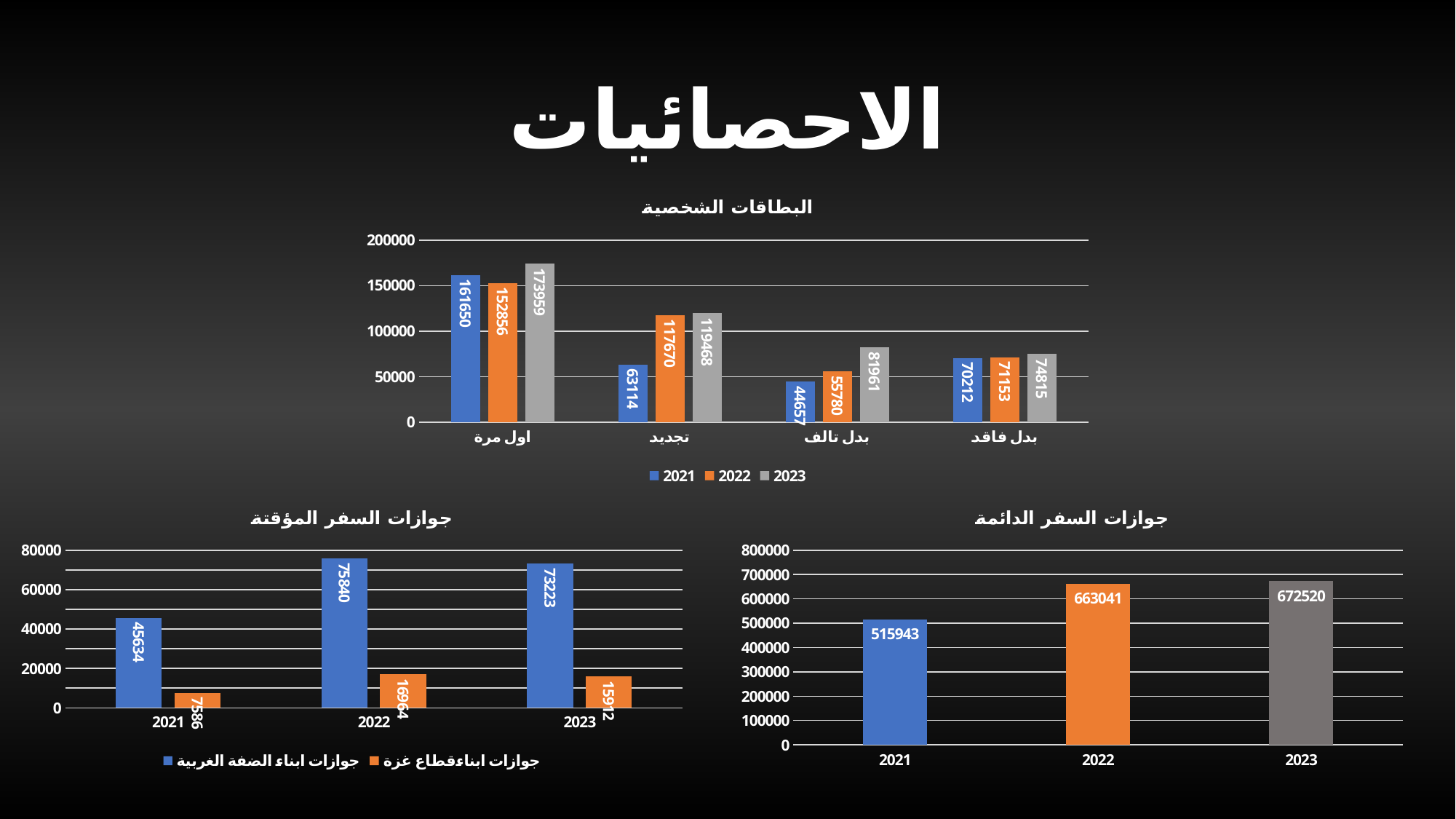
In the chart titled البطاقات الشخصية, which category has the highest value in 2021? اول مرة In the chart titled جوازات السفر الدائمة, what is the value for 2022? 663041 In the chart titled جوازات السفر المؤقتة, which is larger in 2023: جوازات ابناء الضفة الغربية or جوازات ابناء قطاع غزة? جوازات ابناء الضفة الغربية In the chart titled البطاقات الشخصية, what is the value for اول مرة in 2023? 173959 In the chart titled البطاقات الشخصية, what is the difference between the 2023 and 2021 values for بدل فاقد? 4603 In the chart titled جوازات السفر المؤقتة, what is the value for جوازات ابناء الضفة الغربية in 2022? 75840 In the chart titled البطاقات الشخصية, is the 2023 value for بدل تالف greater or less than 100000? less What kind of chart is the chart titled جوازات السفر الدائمة? bar chart In the chart titled البطاقات الشخصية, what is the value for تجديد in 2022? 117670 In the chart titled البطاقات الشخصية, how many series does the legend list? 3 In the chart titled جوازات السفر الدائمة, do the values rise or fall from 2021 to 2023? rise In the chart titled جوازات السفر المؤقتة, which year has the lowest value for جوازات ابناء قطاع غزة? 2021